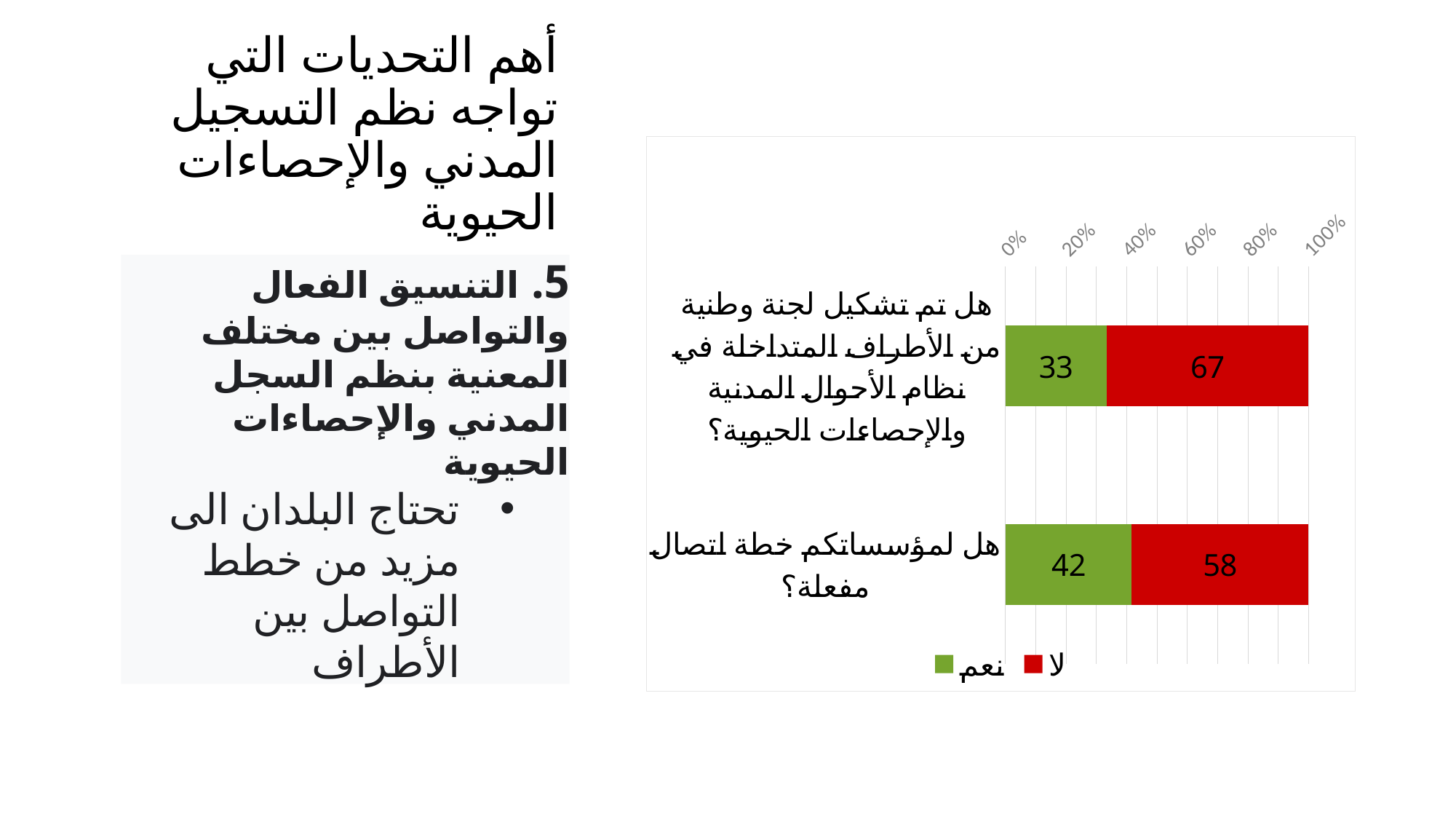
What is the value of نعم for the category "هل لمؤسساتكم خطة اتصال مفعلة؟"? 42 What kind of chart is shown on the slide? Stacked bar chart What is the value of نعم for the category "هل تم تشكيل لجنة وطنية من الأطراف المتداخلة في نظام الأحوال المدنية والإحصاءات الحيوية؟"? 33 Which category has the lower value for لا? هل لمؤسساتكم خطة اتصال مفعلة؟ What is the value of لا for the category "هل تم تشكيل لجنة وطنية من الأطراف المتداخلة في نظام الأحوال المدنية والإحصاءات الحيوية؟"? 67 How many series does the chart legend list? 2 What is the difference between the لا and نعم values for the category "هل تم تشكيل لجنة وطنية من الأطراف المتداخلة في نظام الأحوال المدنية والإحصاءات الحيوية؟"? 34 What is the total of the stacked bar for "هل لمؤسساتكم خطة اتصال مفعلة؟"? 100 What is the value of لا for the category "هل لمؤسساتكم خطة اتصال مفعلة؟"? 58 Which category has the higher value for نعم? هل لمؤسساتكم خطة اتصال مفعلة؟ How many categories (questions) are plotted in the chart? 2 Which colour represents the series لا in the chart? Red